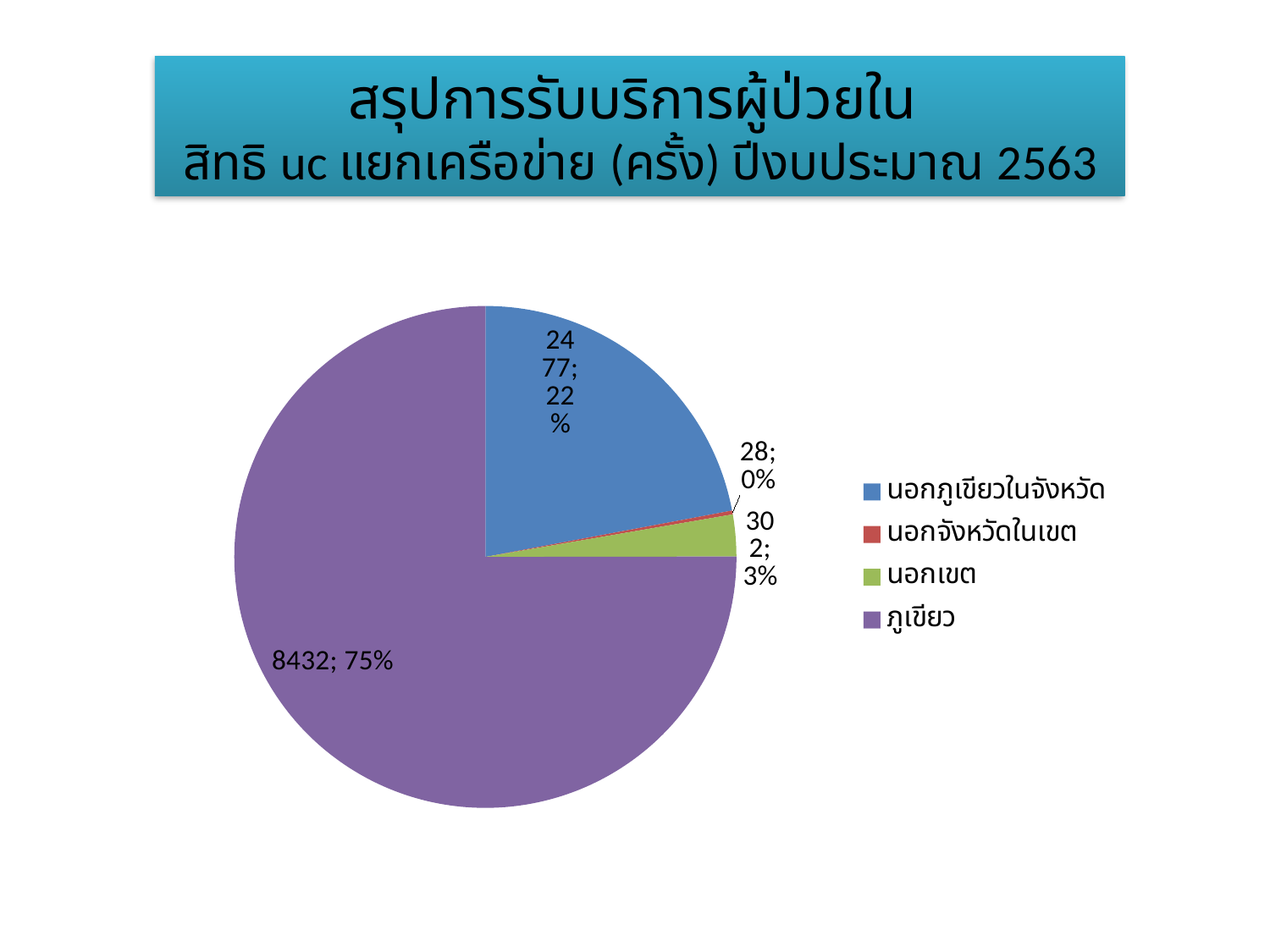
What percentage share does ภูเขียว have? 75% What is the value for ภูเขียว? 8432 Which category has the smallest slice? นอกจังหวัดในเขต What is the value for นอกจังหวัดในเขต? 28 What is the value for นอกเขต? 302 How many slices does the pie chart have? 4 What kind of chart is shown on the slide? pie chart What is the difference between the values for ภูเขียว and นอกภูเขียวในจังหวัด? 5955 What percentage share does นอกภูเขียวในจังหวัด have? 22% What is the value for นอกภูเขียวในจังหวัด? 2477 How many entries does the legend list? 4 Which category has the largest slice? ภูเขียว